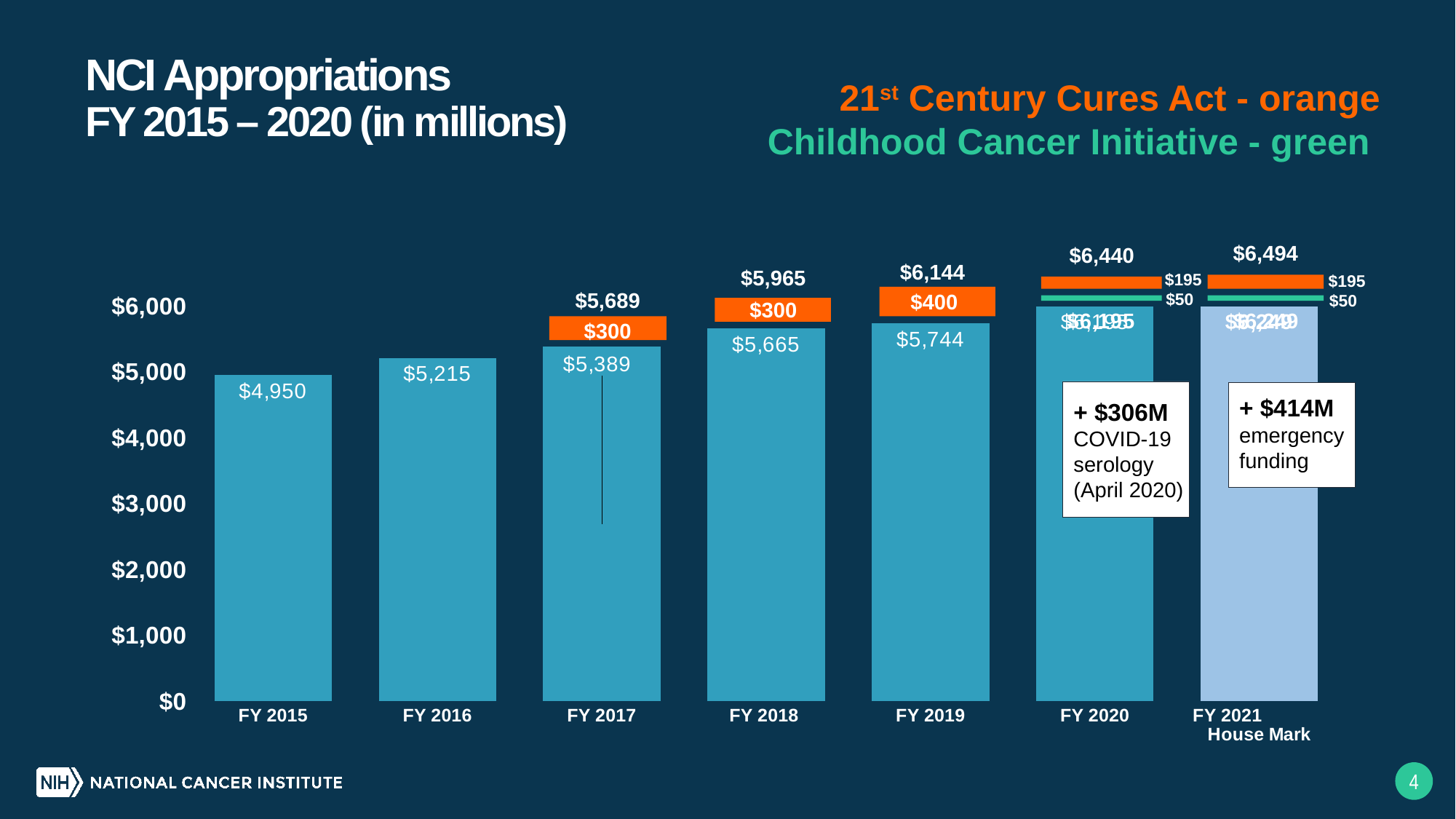
Do the total appropriations rise or fall from FY 2015 to FY 2021? Rise What is the value of the FY 2015 bar? $4,950 How many fiscal year bars are shown in the chart? 7 What is the value of the blue (base) segment of the FY 2017 bar? $5,389 What is the value of the green segment in the FY 2020 bar? $50 By how much does the FY 2016 value exceed the FY 2015 value? $265 What is the total shown above the FY 2018 stacked bar? $5,965 What is the value of the orange segment in the FY 2019 bar? $400 What is the value of the FY 2016 bar? $5,215 Which fiscal year has the lowest appropriation? FY 2015 Which fiscal year has the highest total appropriation? FY 2021 House Mark Which is larger, the blue segment for FY 2018 or the blue segment for FY 2019? FY 2019